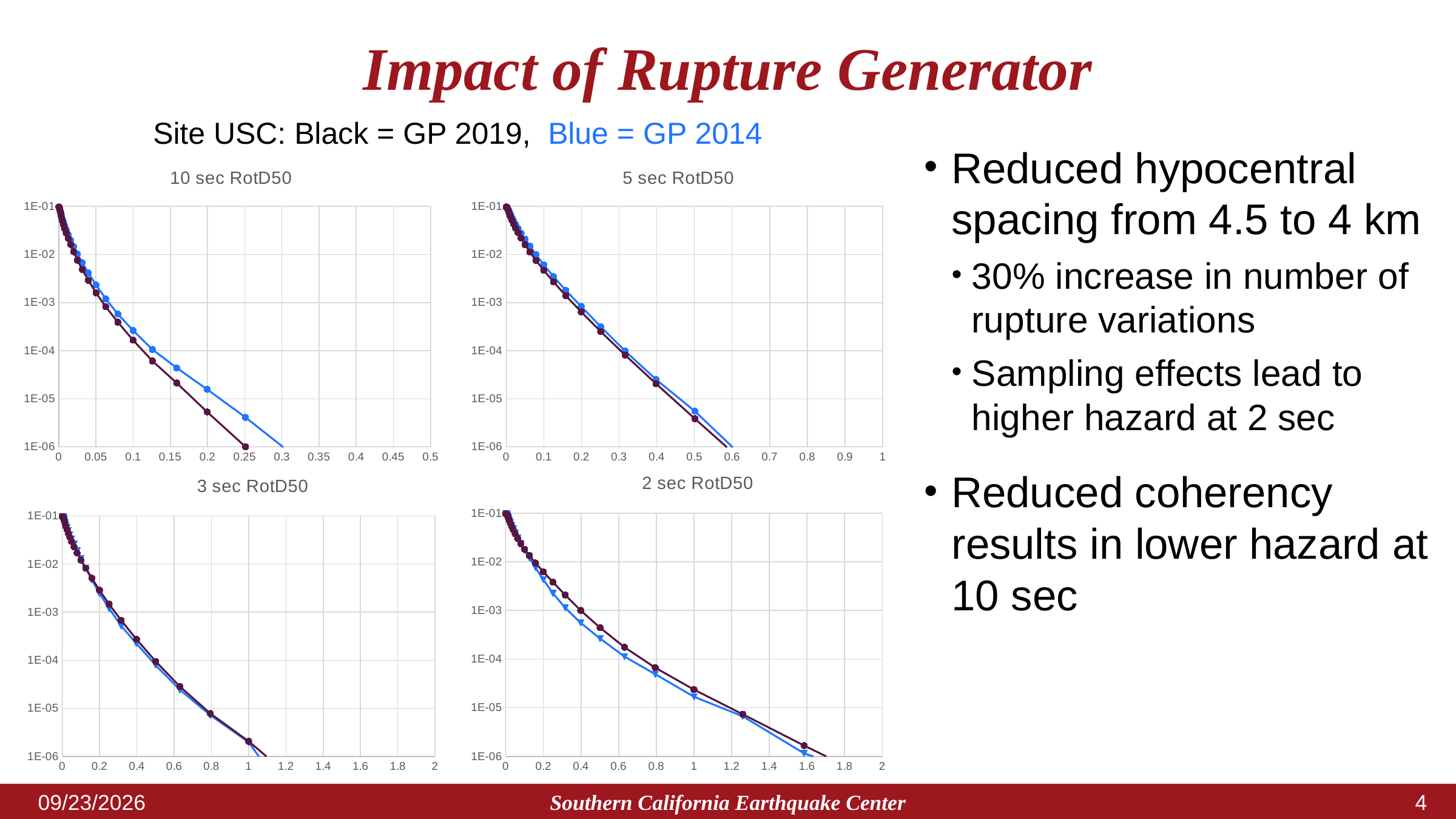
In the 2 sec RotD50 chart, is the value of the black series at x = 1 greater or less than 1E-04? less What kind of chart is the 10 sec RotD50 chart? line chart What is the title of the bottom-right chart? 2 sec RotD50 In the 2 sec RotD50 chart, do the values rise or fall along the x axis? fall In the 10 sec RotD50 chart, at x = 0.2, which series is higher, the blue (GP 2014) or the black (GP 2019)? blue (GP 2014) What is the lowest value shown on the y axis of the 10 sec RotD50 chart? 1E-06 In the 3 sec RotD50 chart, is the value of the black series at x = 0.4 greater or less than 1E-03? less In the 5 sec RotD50 chart, is the value of the black series at x = 0.5 greater or less than 1E-05? less In the 5 sec RotD50 chart, do the values rise or fall as the x axis increases? fall How many series are plotted in the 3 sec RotD50 chart? 2 In the 2 sec RotD50 chart, at x = 0.6, which series is higher, the blue (GP 2014) or the black (GP 2019)? black (GP 2019)